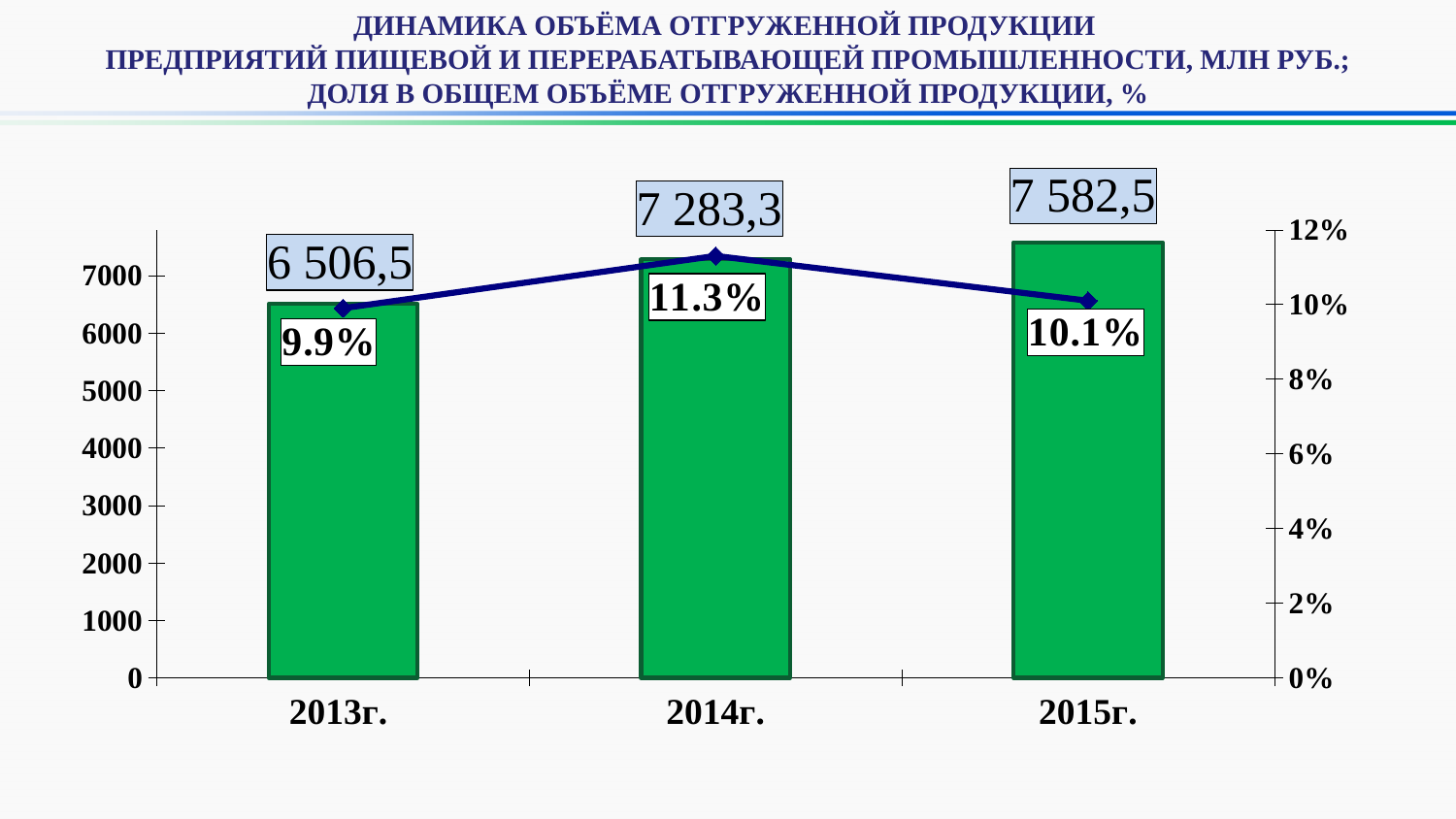
What colour are the bars in the chart? green What is the difference between the share values for 2014г. and 2013г.? 1.4% Which year has the highest bar value for shipped products? 2015г. Do the bar values rise or fall from 2013г. to 2015г.? rise Which year has the lowest share (line value)? 2013г. What share (line value) is shown for 2013г.? 9.9% How many years are shown on the x axis? 3 What is the difference between the bar values for 2015г. and 2014г.? 299,2 What is the volume of shipped products (bar value) for 2013г.? 6 506,5 Which year has the larger share value, 2014г. or 2015г.? 2014г. What share (line value) is shown for 2014г.? 11.3% What is the volume of shipped products (bar value) for 2015г.? 7 582,5